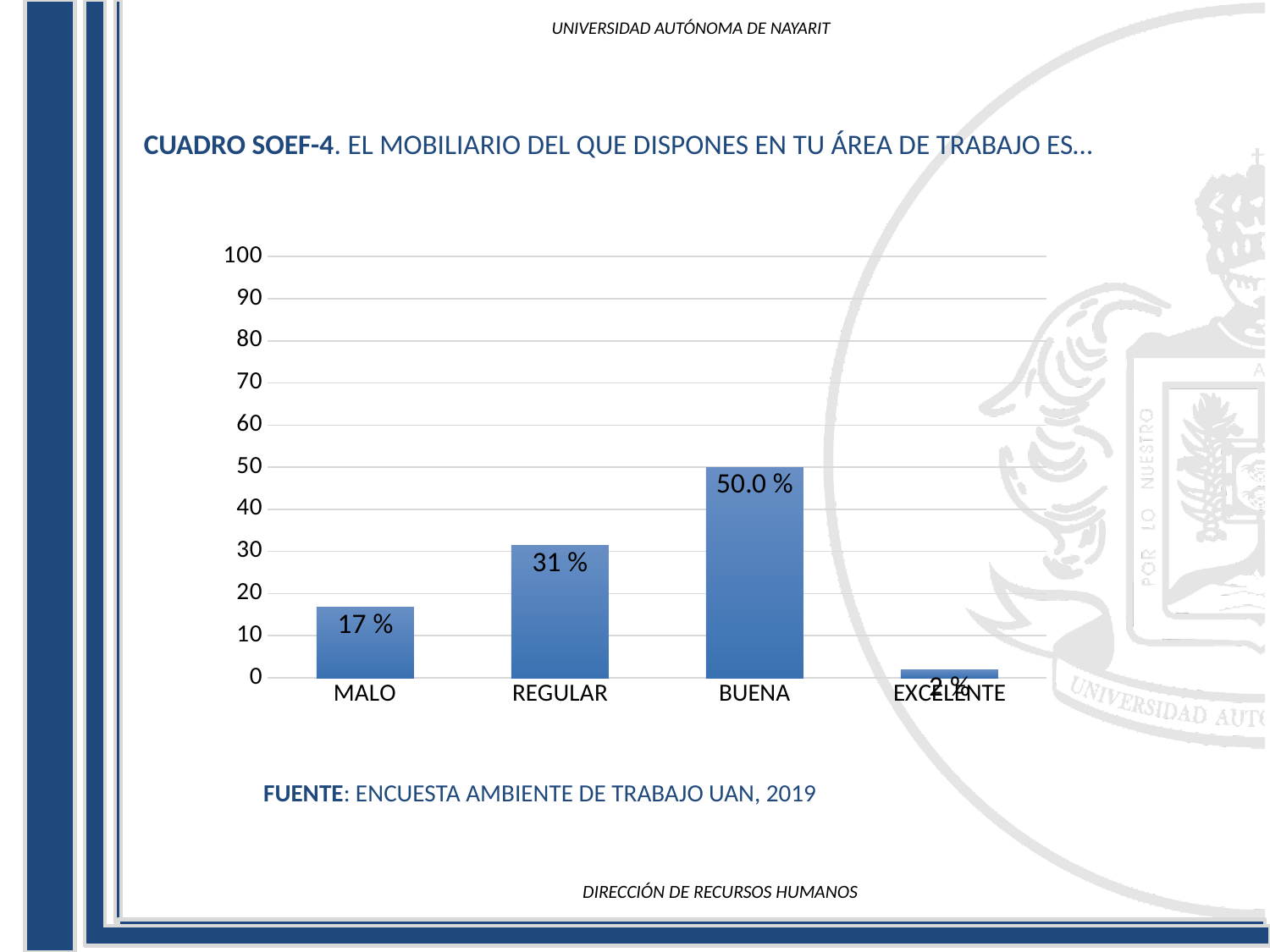
Which category has the highest value? BUENA What is the difference between the values for BUENA and MALO? 33 % What kind of chart is shown on the slide? bar chart What is the difference between the values for REGULAR and MALO? 14 % Which category has the lowest value? EXCELENTE What is the value shown for BUENA? 50.0 % What is the value shown for MALO? 17 % What is the source cited below the chart? ENCUESTA AMBIENTE DE TRABAJO UAN, 2019 How many categories are shown on the x axis? 4 What is the value shown for REGULAR? 31 % Which is larger, the value for REGULAR or the value for MALO? REGULAR Is the value for EXCELENTE greater or less than 10? less